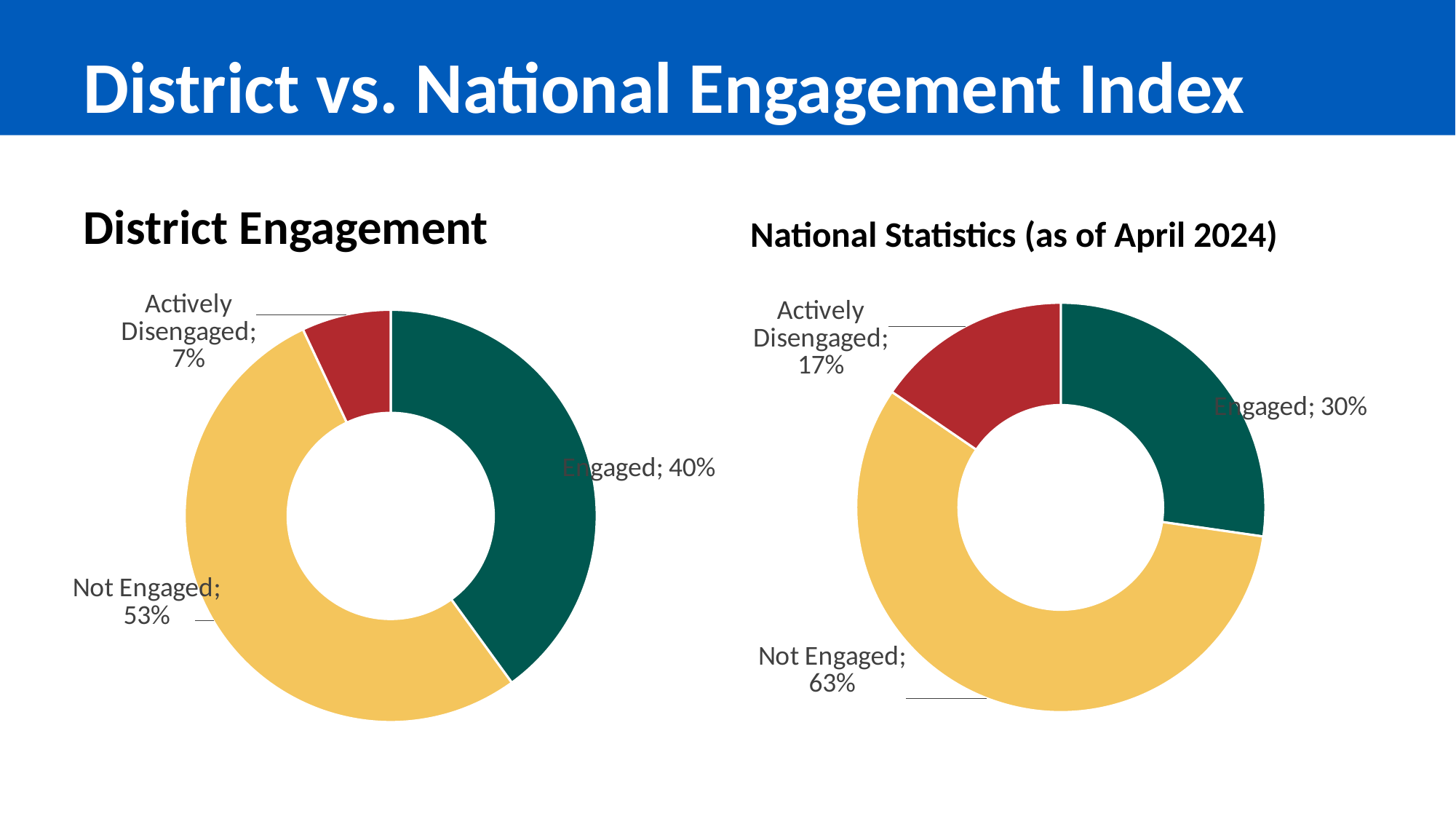
In the District Engagement chart, what colour is the Not Engaged segment? Yellow How many categories does the District Engagement chart show? 3 In the National Statistics (as of April 2024) chart, which category has the largest share? Not Engaged What is the difference between the Engaged share in the District Engagement chart and the Engaged share in the National Statistics (as of April 2024) chart? 10% In the District Engagement chart, which category has the smallest share? Actively Disengaged In the District Engagement chart, what is the value for Not Engaged? 53% Which is larger: Actively Disengaged in the District Engagement chart or Actively Disengaged in the National Statistics (as of April 2024) chart? National Statistics (as of April 2024) In the National Statistics (as of April 2024) chart, what is the difference between Not Engaged and Engaged? 33% In the National Statistics (as of April 2024) chart, what is the value for Actively Disengaged? 17% In the District Engagement chart, what is the value for Engaged? 40% What kind of chart is the National Statistics (as of April 2024) chart? Doughnut chart What is the title of the chart on the right side of the slide? National Statistics (as of April 2024)